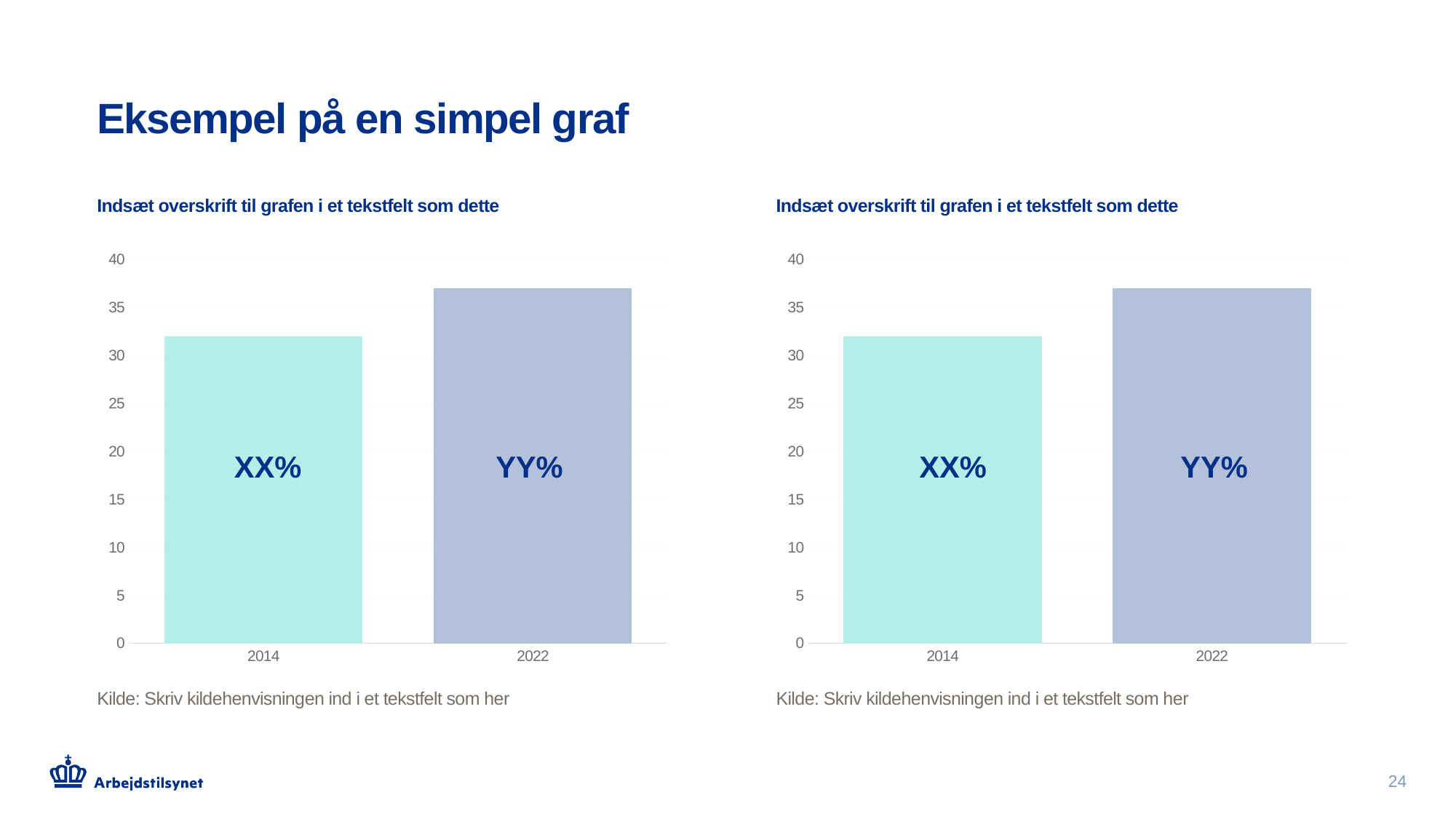
How many categories are shown on the x axis of the left chart? 2 In the left chart, is the bar for 2022 greater or less than 35? greater In the right chart, is the bar for 2022 greater or less than 40? less In the left chart, which year has the highest bar? 2022 In the right chart, which year has the lowest bar? 2014 What kind of chart is the left chart on the slide? bar chart In the left chart, do the values rise or fall from 2014 to 2022? rise In the right chart, which bar is taller, 2014 or 2022? 2022 What is the highest tick value shown on the y axis of the right chart? 40 What placeholder label is printed on the 2022 bar in the left chart? YY% In the left chart, is the bar for 2014 greater or less than 30? greater